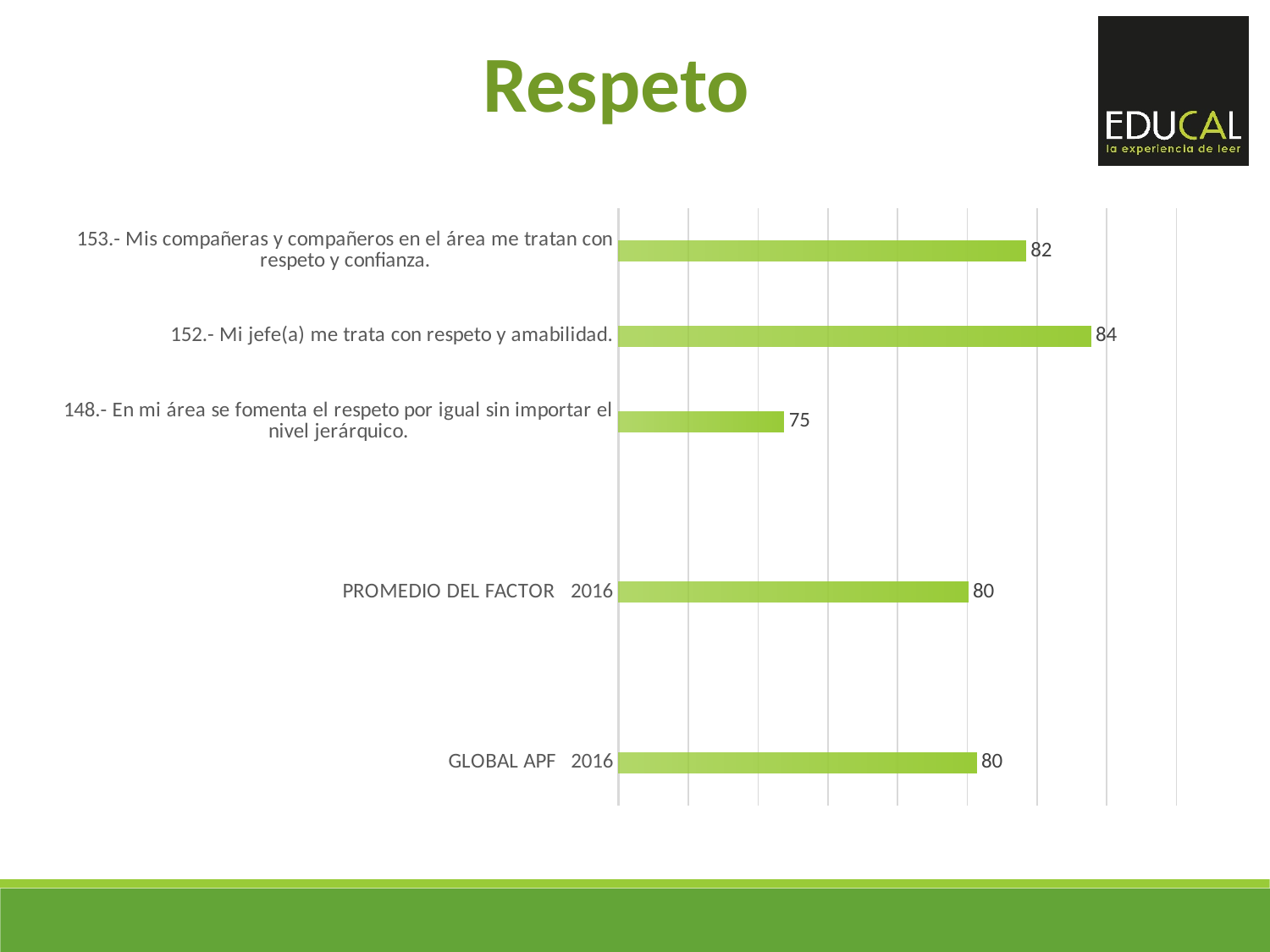
What is the value for item 152 (Mi jefe(a) me trata con respeto y amabilidad)? 84 What is the value for item 153 (Mis compañeras y compañeros en el área me tratan con respeto y confianza)? 82 What is the difference between the values for item 152 and item 148? 9 What is the difference between the value for item 153 and PROMEDIO DEL FACTOR 2016? 2 Which category has the highest value? 152.- Mi jefe(a) me trata con respeto y amabilidad. Which is larger, the value for item 153 or the value for item 148? 153.- Mis compañeras y compañeros en el área me tratan con respeto y confianza. What is the value for GLOBAL APF 2016? 80 What is the value for PROMEDIO DEL FACTOR 2016? 80 What is the value for item 148 (En mi área se fomenta el respeto por igual sin importar el nivel jerárquico)? 75 Which category has the lowest value? 148.- En mi área se fomenta el respeto por igual sin importar el nivel jerárquico. How many bars are shown in the chart? 5 What kind of chart is shown on the slide? Bar chart